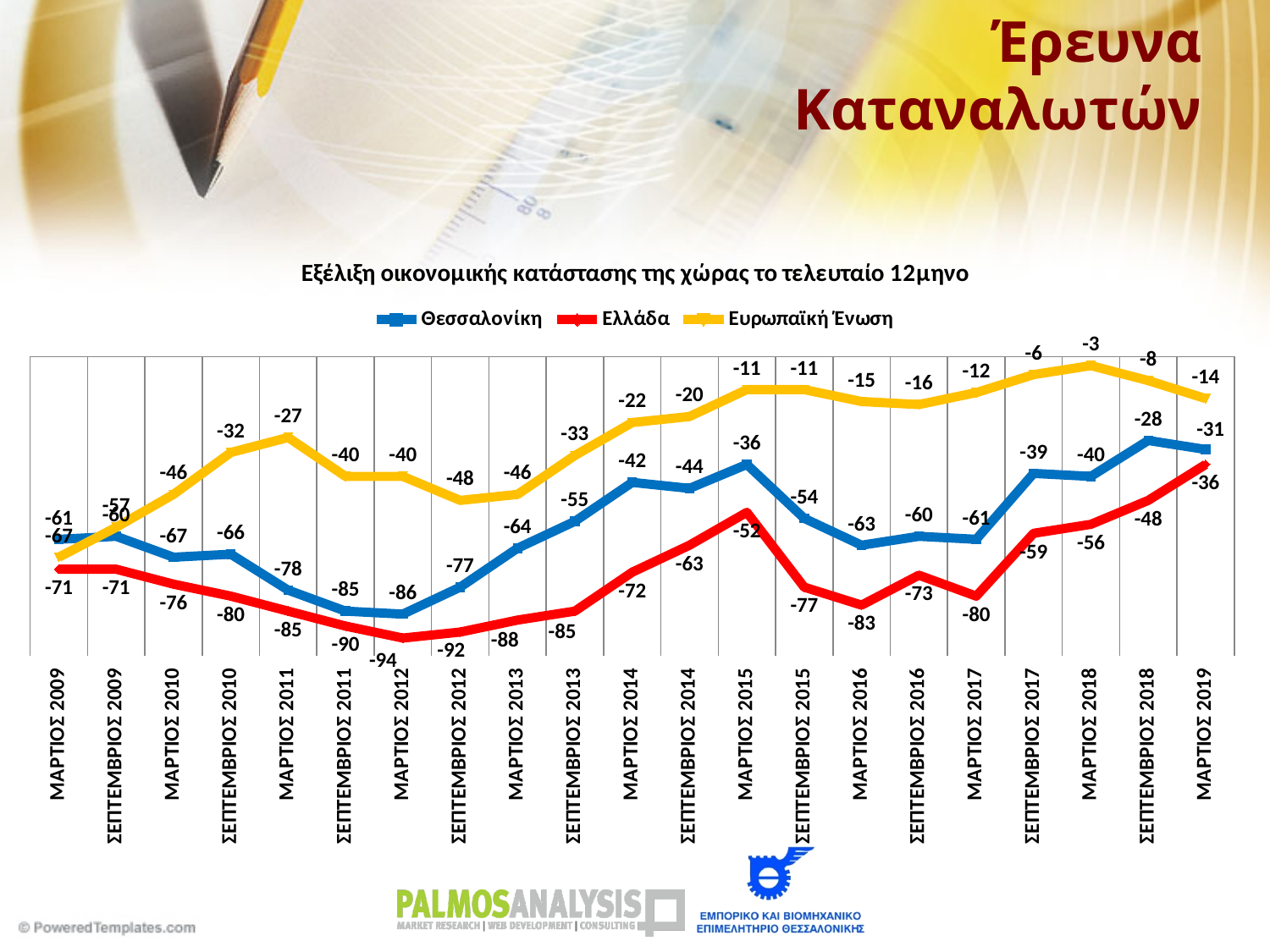
How many time points are plotted along the x axis? 21 How many series does the legend list? 3 What is the value for Θεσσαλονίκη in ΣΕΠΤΕΜΒΡΙΟΣ 2011? -85 Does the Ευρωπαϊκή Ένωση series rise or fall from ΜΑΡΤΙΟΣ 2009 to ΜΑΡΤΙΟΣ 2011? rise What is the value for Ελλάδα in ΜΑΡΤΙΟΣ 2019? -36 What kind of chart is shown on the slide? line chart In which period does the Ευρωπαϊκή Ένωση series reach its highest value? ΜΑΡΤΙΟΣ 2018 What is the value for Ευρωπαϊκή Ένωση in ΜΑΡΤΙΟΣ 2018? -3 In ΜΑΡΤΙΟΣ 2015, which is higher: Θεσσαλονίκη or Ελλάδα? Θεσσαλονίκη What is the difference between the Θεσσαλονίκη and Ελλάδα values in ΜΑΡΤΙΟΣ 2019? 5 In which period does the Ελλάδα series reach its lowest value? ΜΑΡΤΙΟΣ 2012 What colour is the Ελλάδα line in the chart? red